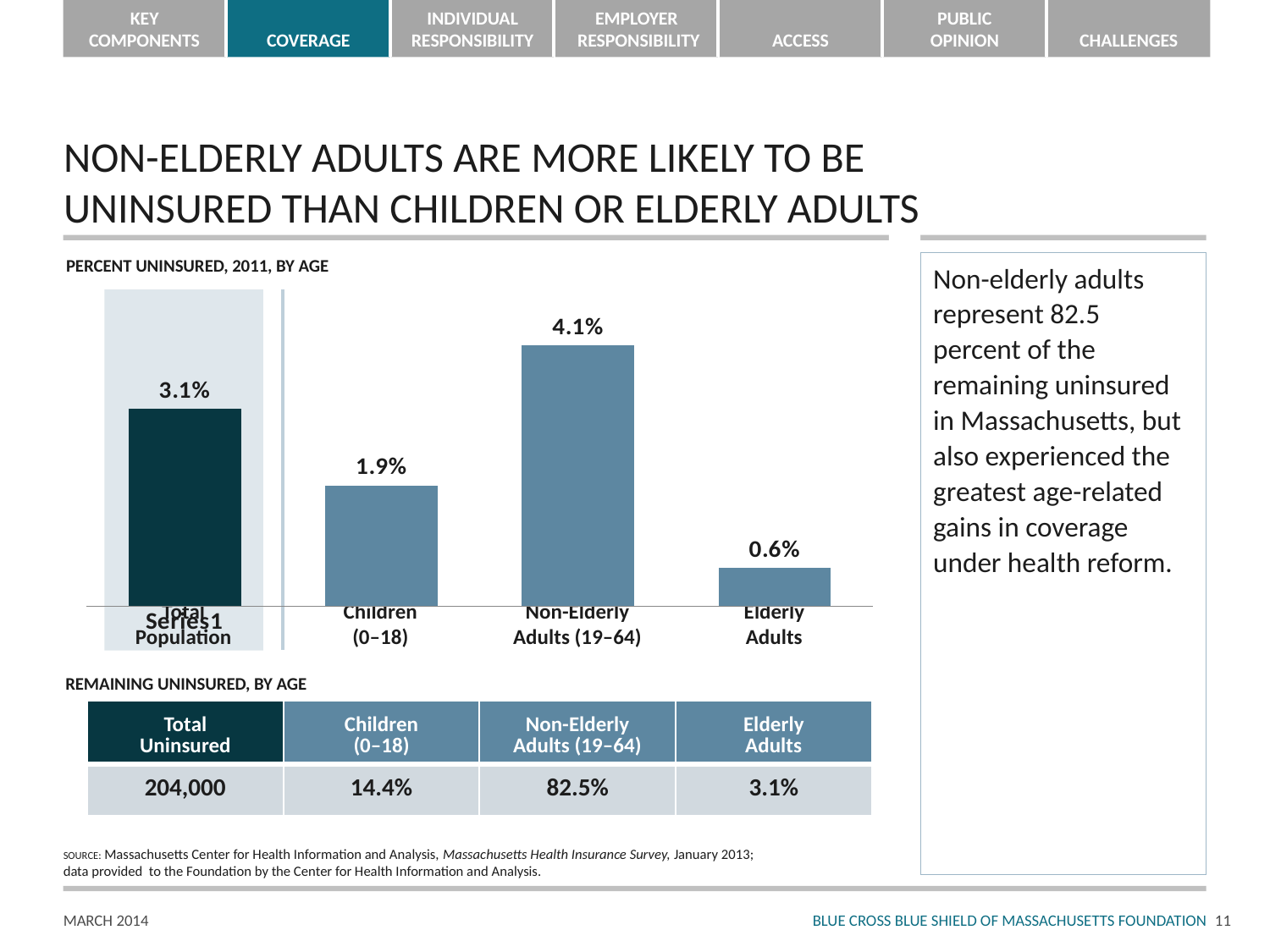
What is the percent uninsured for the Total Population? 3.1% What is the difference in percent uninsured between Non-Elderly Adults (19–64) and Children (0–18)? 2.2% What type of chart is shown on the slide? Bar chart How many bars are shown in the chart? 4 Which has a higher percent uninsured, Children (0–18) or Elderly Adults? Children (0–18) What is the percent uninsured for Elderly Adults? 0.6% What is the difference in percent uninsured between the Total Population and Elderly Adults? 2.5% Which age group has the highest percent uninsured? Non-Elderly Adults (19–64) What is the percent uninsured for Children (0–18)? 1.9% What is the percent uninsured for Non-Elderly Adults (19–64)? 4.1% What is the title of the chart? PERCENT UNINSURED, 2011, BY AGE Which age group has the lowest percent uninsured? Elderly Adults